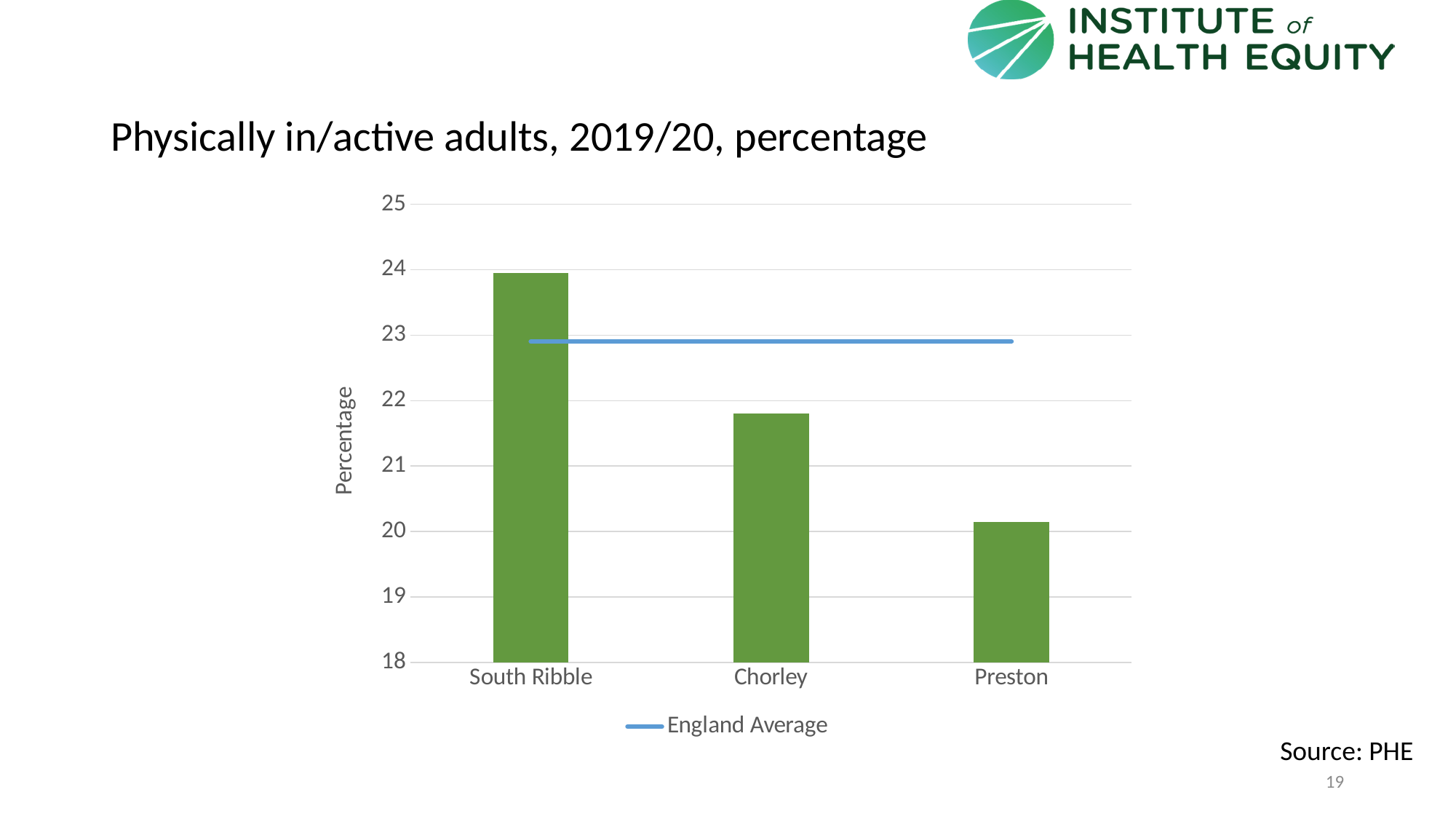
Which area has the lowest percentage of physically inactive adults? Preston Is the England Average line above or below 23? below Is the value for Preston greater or less than 20? greater Do the bar values rise or fall from South Ribble to Preston along the x axis? fall Which has the larger value, Chorley or Preston? Chorley Is the value for Chorley greater or less than 22? less What does the blue horizontal line represent according to the legend? England Average What is the title of the chart? Physically in/active adults, 2019/20, percentage Which area has the highest percentage of physically inactive adults? South Ribble What kind of chart is shown on the slide? bar chart How many areas (bars) are plotted on the chart? 3